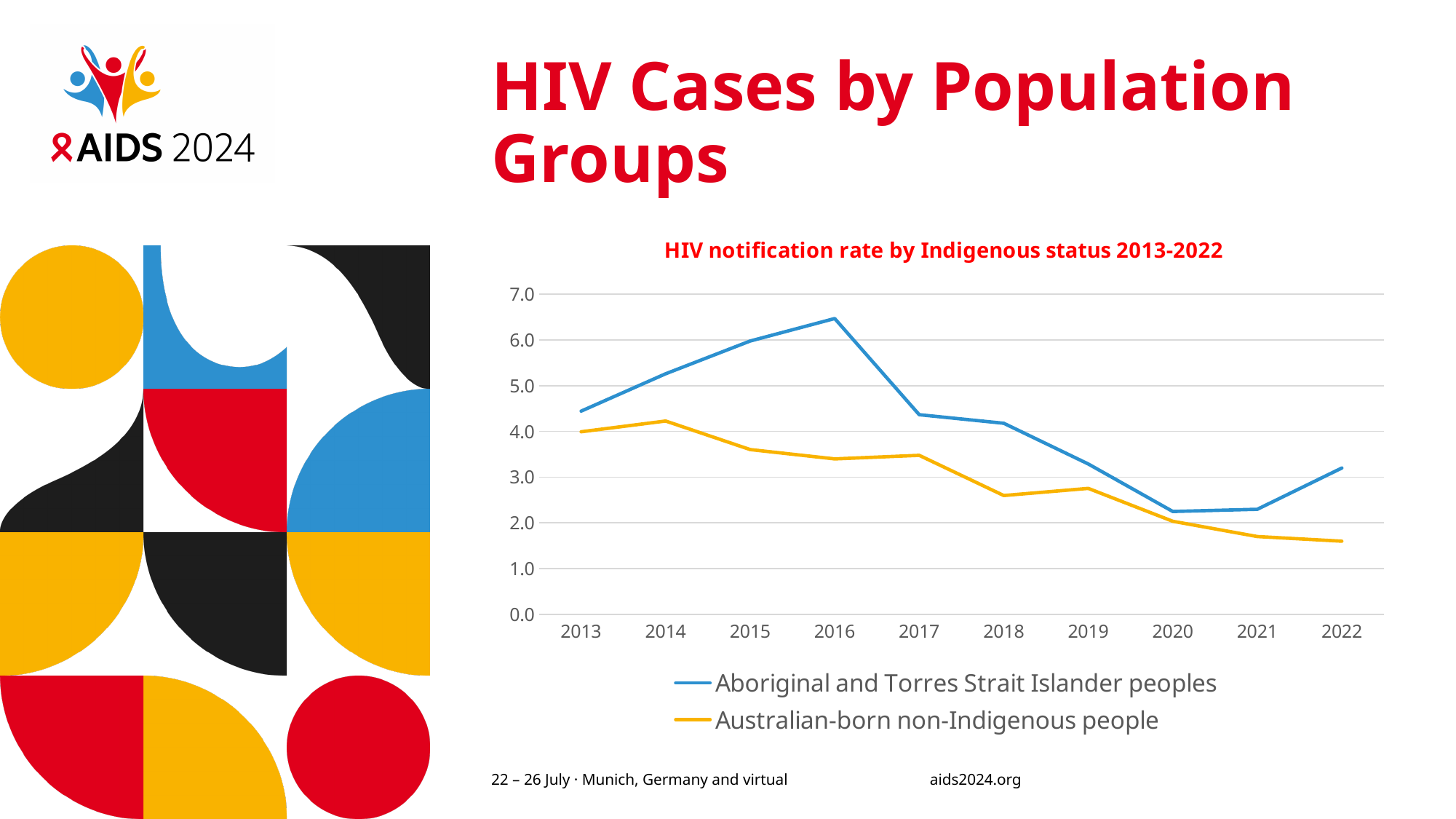
In 2016, which group has the higher HIV notification rate? Aboriginal and Torres Strait Islander peoples Is the 2022 value for Australian-born non-Indigenous people greater or less than 2.0? less In which year is the HIV notification rate for Australian-born non-Indigenous people highest? 2014 Is the 2018 value for Australian-born non-Indigenous people greater or less than 3.0? less Is the 2016 value for Aboriginal and Torres Strait Islander peoples greater or less than 6.0? greater In which year is the HIV notification rate for Aboriginal and Torres Strait Islander peoples highest? 2016 What kind of chart is shown on the slide? Line chart How many years are shown on the x axis? 10 How many series does the legend list? 2 Does the HIV notification rate for Australian-born non-Indigenous people generally rise or fall from 2014 to 2022? Fall What is the title of the chart? HIV notification rate by Indigenous status 2013-2022